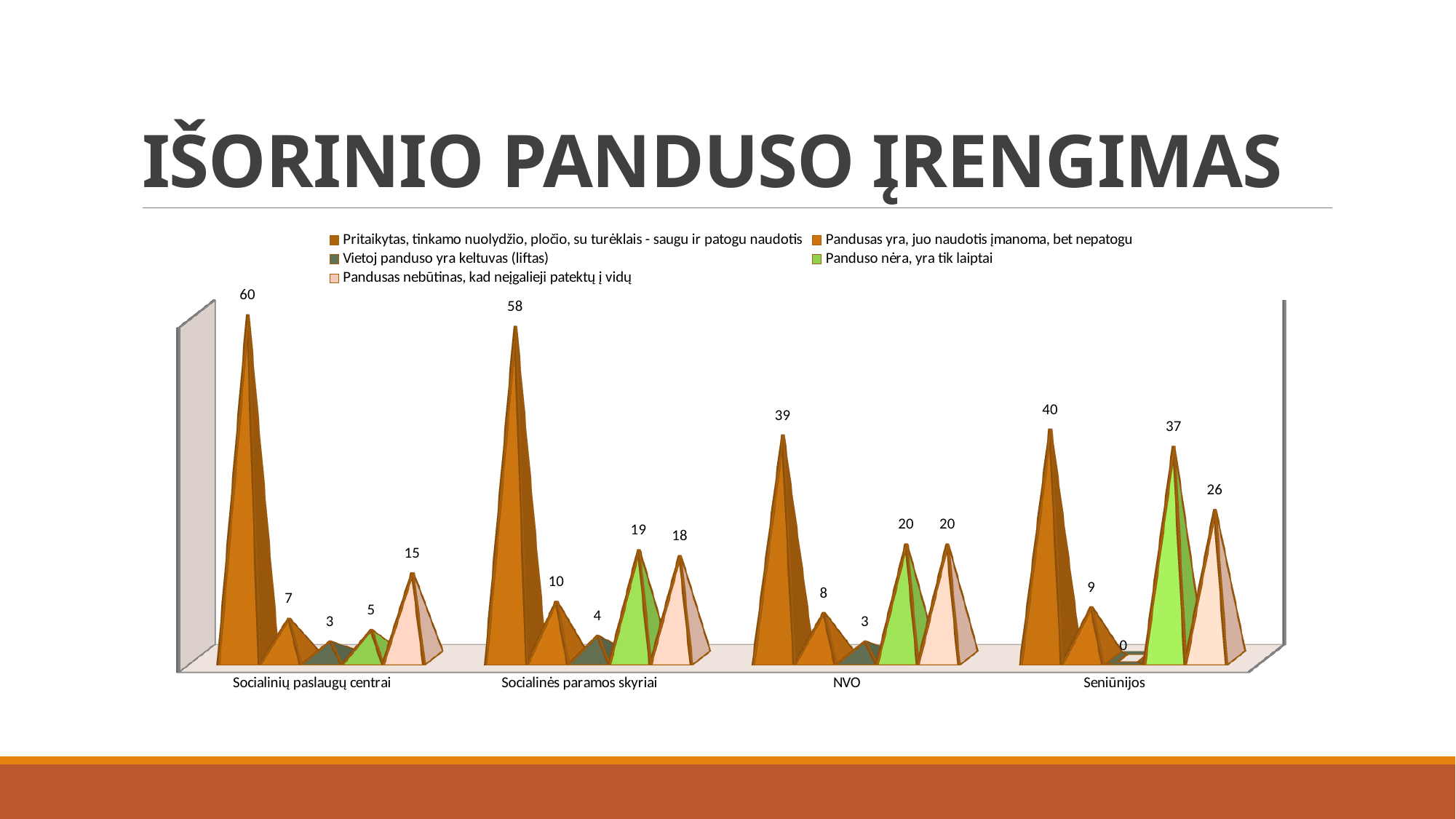
What is the value for "Pandusas nebūtinas, kad neįgalieji patektų į vidų" in the NVO category? 20 Which is larger: the "Pandusas yra, juo naudotis įmanoma, bet nepatogu" value for Socialinės paramos skyriai or for Seniūnijos? Socialinės paramos skyriai What is the difference between the "Pritaikytas, tinkamo nuolydžio, pločio, su turėklais - saugu ir patogu naudotis" values for Socialinių paslaugų centrai and NVO? 21 What kind of chart is shown on the slide? Bar chart What is the value for "Panduso nėra, yra tik laiptai" in the Seniūnijos category? 37 Which category has the highest value for "Pritaikytas, tinkamo nuolydžio, pločio, su turėklais - saugu ir patogu naudotis"? Socialinių paslaugų centrai How many categories are shown on the x axis? 4 How many series does the legend list? 5 What is the value for "Pritaikytas, tinkamo nuolydžio, pločio, su turėklais - saugu ir patogu naudotis" in the Socialinių paslaugų centrai category? 60 What is the title of the slide containing the chart? IŠORINIO PANDUSO ĮRENGIMAS What is the value for "Vietoj panduso yra keltuvas (liftas)" in the Seniūnijos category? 0 Which category has the lowest value for "Panduso nėra, yra tik laiptai"? Socialinių paslaugų centrai